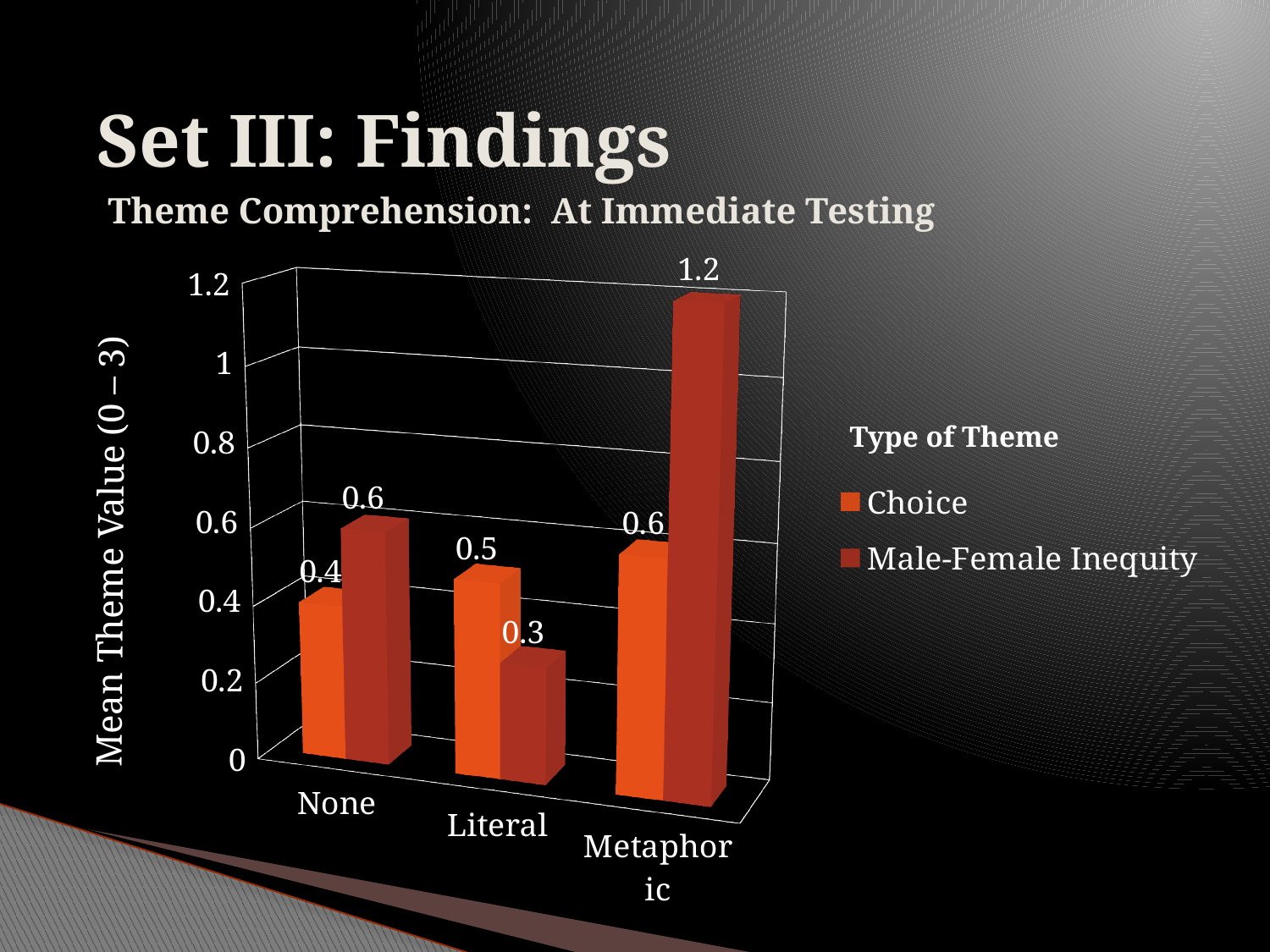
Which category has the lowest Choice value? None What kind of chart is shown on the slide? Bar chart What is the Male-Female Inequity value for the Literal category? 0.3 What is the difference between the Male-Female Inequity value and the Choice value for the Metaphoric category? 0.6 How many series does the legend list? 2 How many categories are shown on the x axis? 3 What is the Choice value for the None category? 0.4 Which category has the highest Male-Female Inequity value? Metaphoric What is the Male-Female Inequity value for the Metaphoric category? 1.2 For the Literal category, which series has the larger value, Choice or Male-Female Inequity? Choice What is the title of the chart's legend? Type of Theme What is the Choice value for the Literal category? 0.5